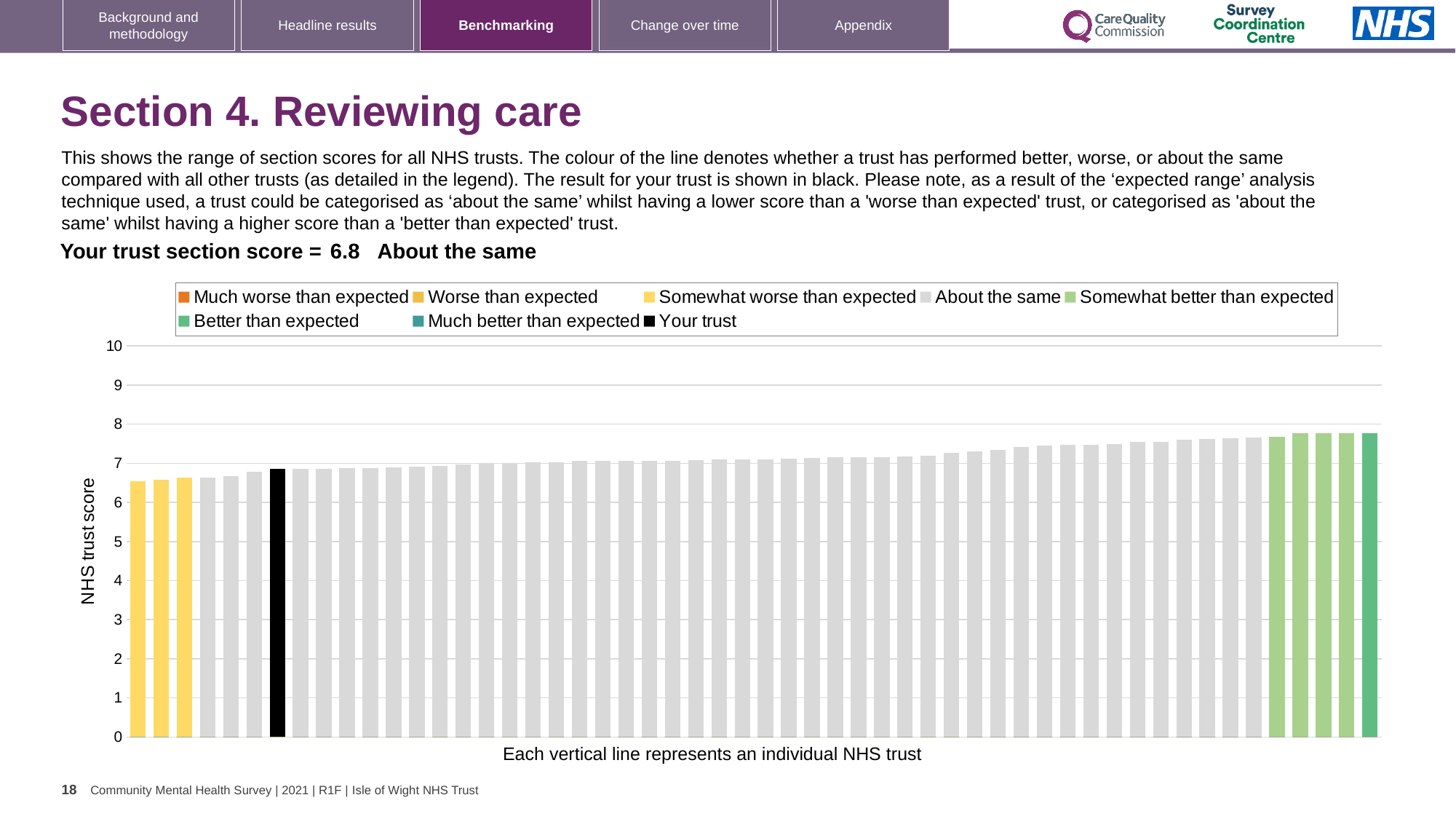
What kind of chart is shown on the slide? bar chart How many bars are coloured yellow (Somewhat worse than expected)? 3 Is the value of the shortest bar in the chart greater or less than 6? greater What is the section score for your trust shown on the slide? 6.8 What is the label on the y axis of the chart? NHS trust score What is the label on the x axis of the chart? Each vertical line represents an individual NHS trust Is the value of the tallest bar in the chart greater or less than 8? less Is the value of the black 'Your trust' bar greater or less than 5? greater How many entries does the chart legend list? 8 Which category is your trust placed in for this section? About the same How many bars are coloured black (Your trust)? 1 Do the bar values rise or fall from left to right along the x axis? rise